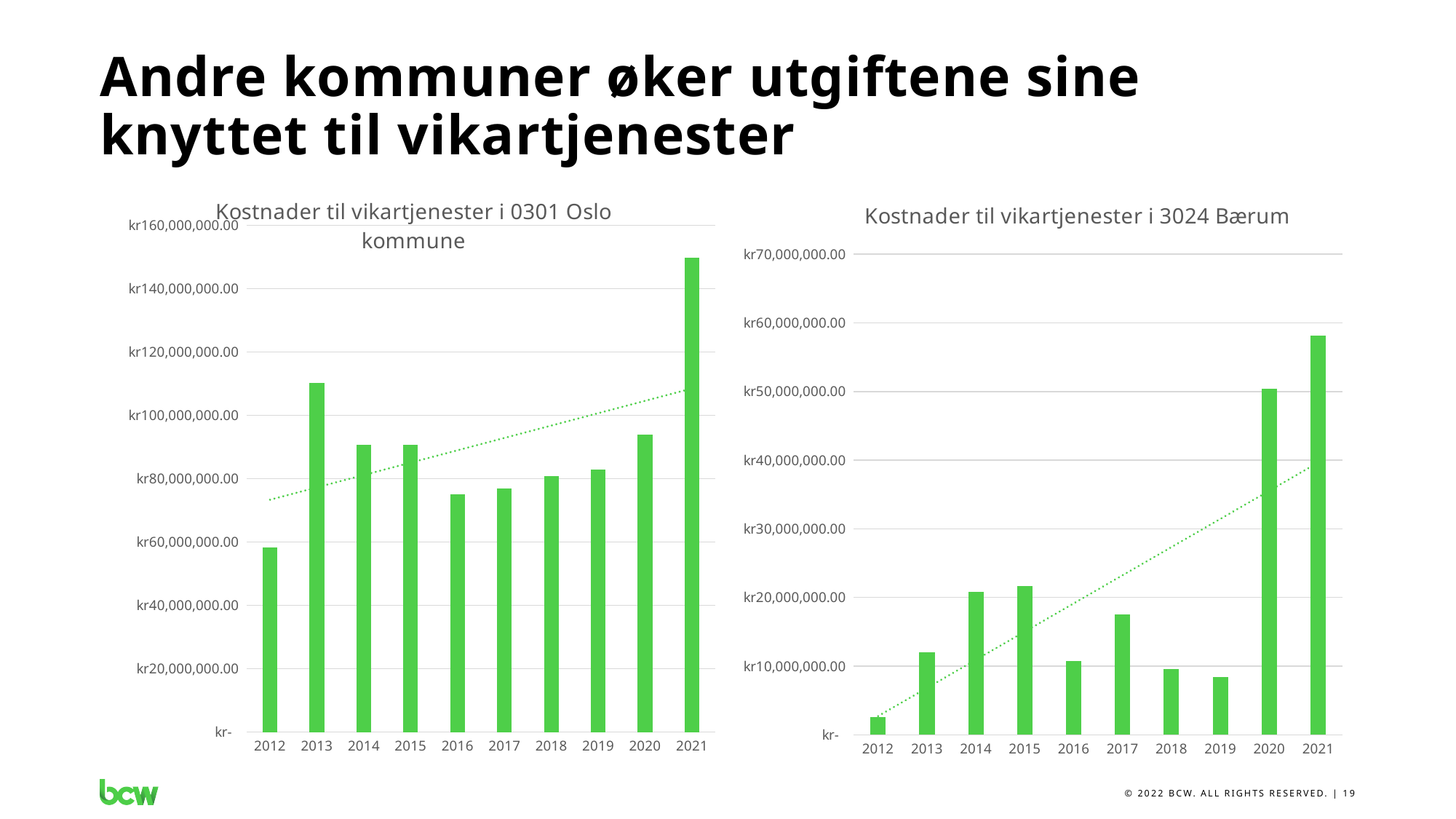
In the chart "Kostnader til vikartjenester i 3024 Bærum", which year has the lowest value? 2012 In the chart "Kostnader til vikartjenester i 3024 Bærum", which is larger, the value for 2014 or the value for 2016? 2014 In the chart "Kostnader til vikartjenester i 0301 Oslo kommune", which year has the highest value? 2021 In the chart "Kostnader til vikartjenester i 3024 Bærum", which year has the highest value? 2021 In the chart "Kostnader til vikartjenester i 0301 Oslo kommune", is the value for 2013 greater or less than kr100,000,000.00? greater In the chart "Kostnader til vikartjenester i 0301 Oslo kommune", is the value for 2021 greater or less than kr140,000,000.00? greater In the chart "Kostnader til vikartjenester i 0301 Oslo kommune", which is larger, the value for 2013 or the value for 2020? 2013 In the chart "Kostnader til vikartjenester i 0301 Oslo kommune", which year has the lowest value? 2012 How many years are shown on the x axis of the chart "Kostnader til vikartjenester i 0301 Oslo kommune"? 10 In the chart "Kostnader til vikartjenester i 3024 Bærum", does the dotted trend line rise or fall from 2012 to 2021? rise In the chart "Kostnader til vikartjenester i 3024 Bærum", is the value for 2019 greater or less than kr10,000,000.00? less What kind of chart is "Kostnader til vikartjenester i 0301 Oslo kommune"? bar chart